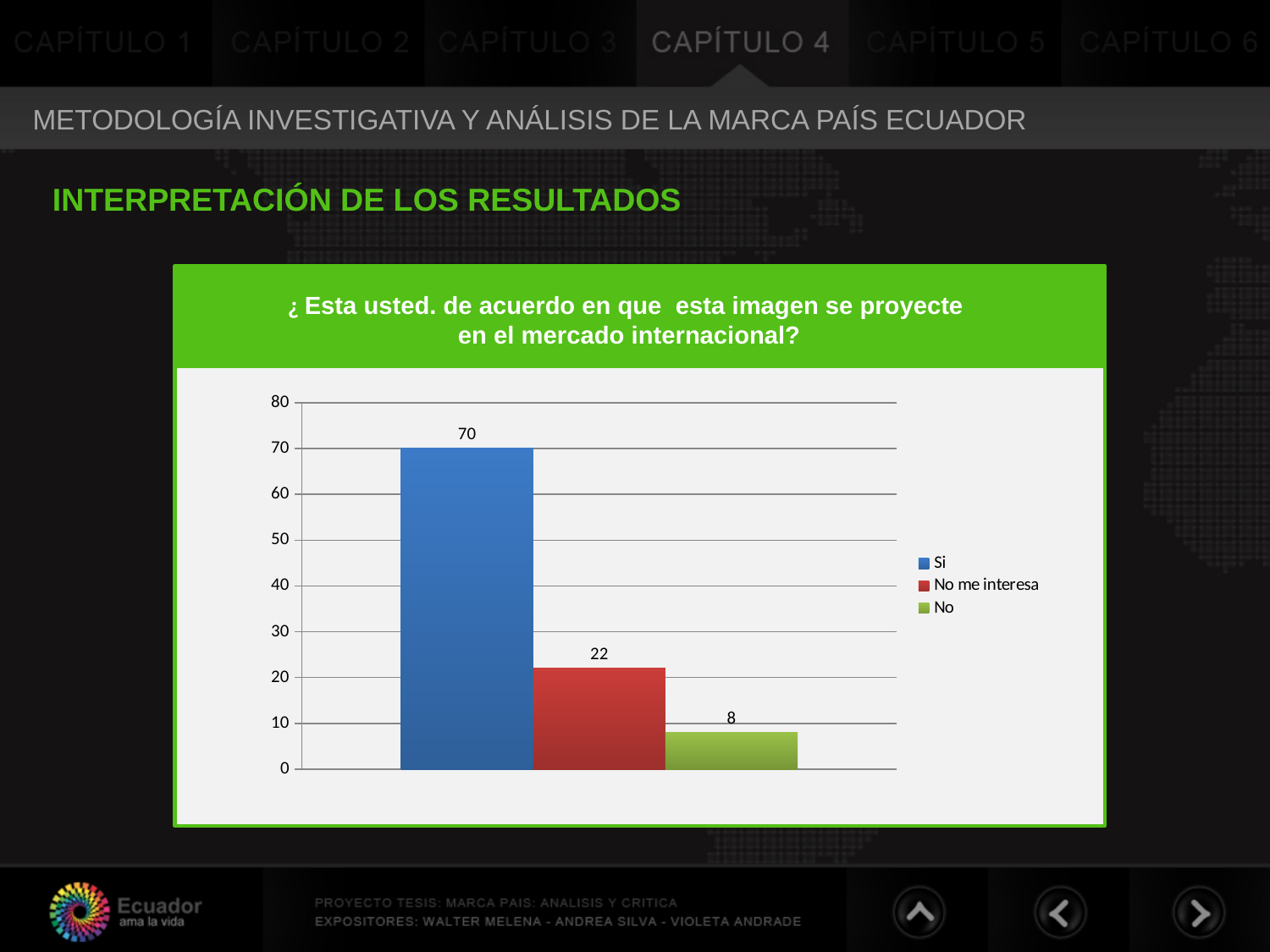
What is the value for "No"? 8 What is the difference between the values for "Si" and "No me interesa"? 48 What colour is the bar for "Si"? Blue What kind of chart is shown on the slide? Bar chart Is the value for "Si" greater or less than 60? greater Which response has the lowest value? No Which is larger, the value for "No me interesa" or the value for "No"? No me interesa What is the value for "No me interesa"? 22 How many series does the legend list? 3 What is the difference between the values for "No me interesa" and "No"? 14 What is the value for "Si"? 70 Which response has the highest value? Si